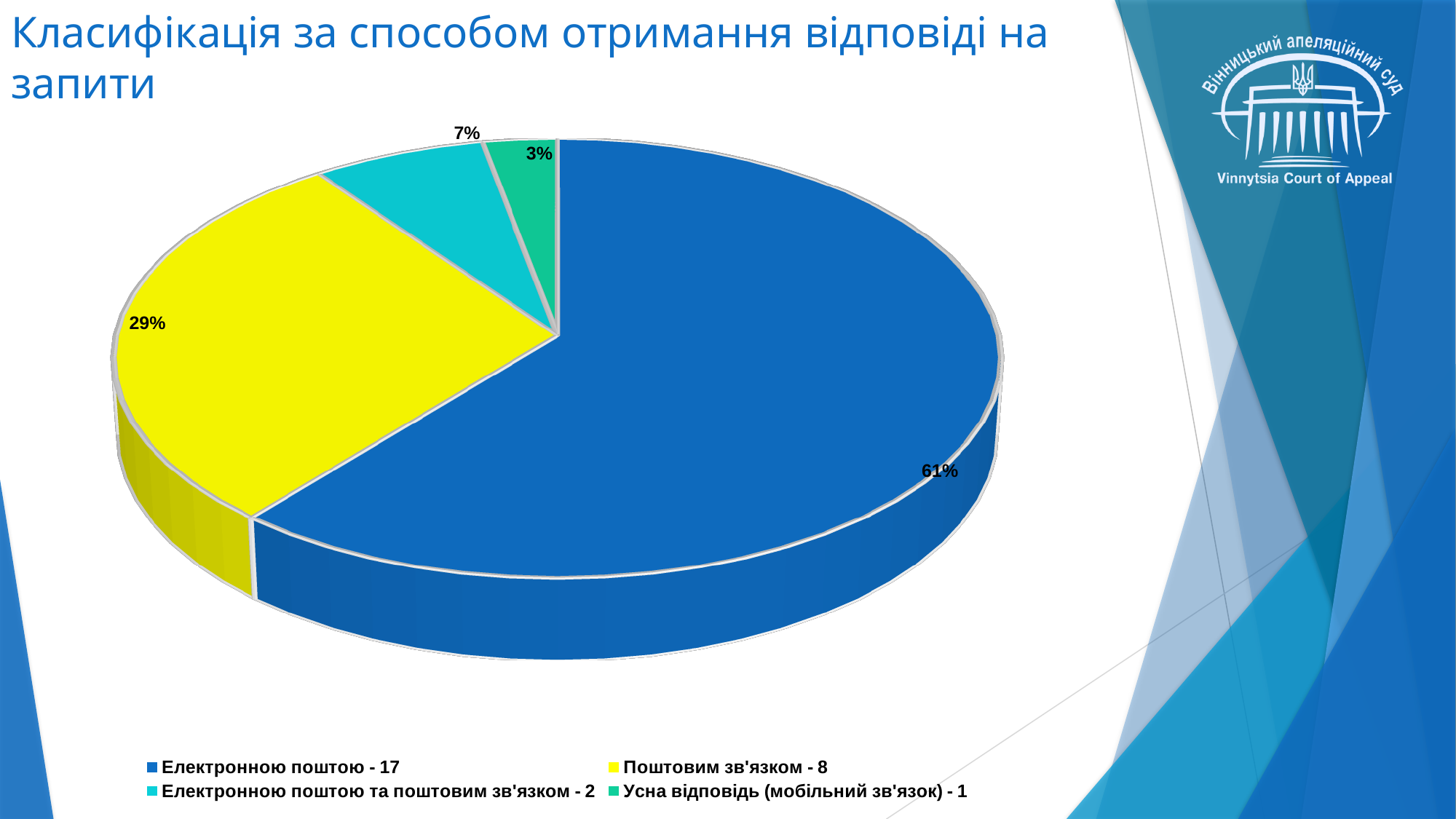
What kind of chart is shown on the slide? Pie chart What percentage share does the slice for "Електронною поштою" have? 61% According to the legend, how many responses were received by "Поштовим зв'язком"? 8 What percentage share does the slice for "Електронною поштою та поштовим зв'язком" have? 7% Which category has the largest slice of the pie? Електронною поштою What is the difference in percentage points between the "Електронною поштою" slice and the "Поштовим зв'язком" slice? 32 Which category has the smallest slice of the pie? Усна відповідь (мобільний зв'язок) What percentage share does the slice for "Усна відповідь (мобільний зв'язок)" have? 3% Which slice is larger: "Поштовим зв'язком" or "Електронною поштою та поштовим зв'язком"? Поштовим зв'язком How many categories does the pie chart show? 4 What colour is the slice for "Поштовим зв'язком"? Yellow